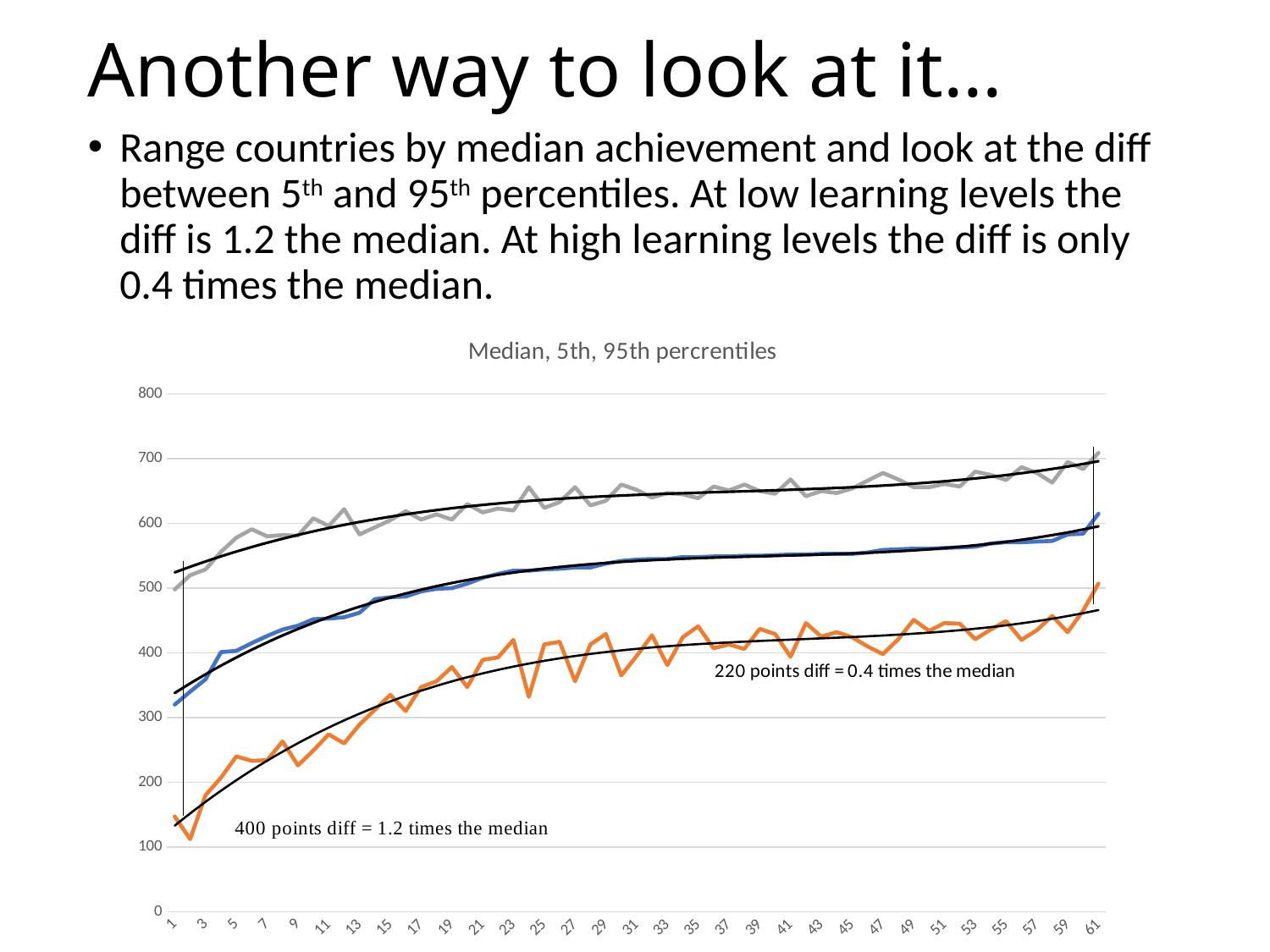
Do the values of the orange line generally rise or fall along the x axis? rise According to the annotation on the right side of the chart, how many points is the difference at high learning levels? 220 points What type of chart is shown on the slide? line chart Is the value of the orange line at x = 61 greater or less than 400? greater At x = 31, which line has the larger value, the gray line or the orange line? gray line How many coloured data series (lines) are plotted in the chart? 3 Is the value of the orange line at x = 1 greater or less than 200? less Is the value of the gray line at x = 61 greater or less than 600? greater Do the values of the blue line rise or fall as you move from left to right along the x axis? rise What is the highest value labelled on the vertical axis? 800 What is the title of the chart? Median, 5th, 95th percrentiles